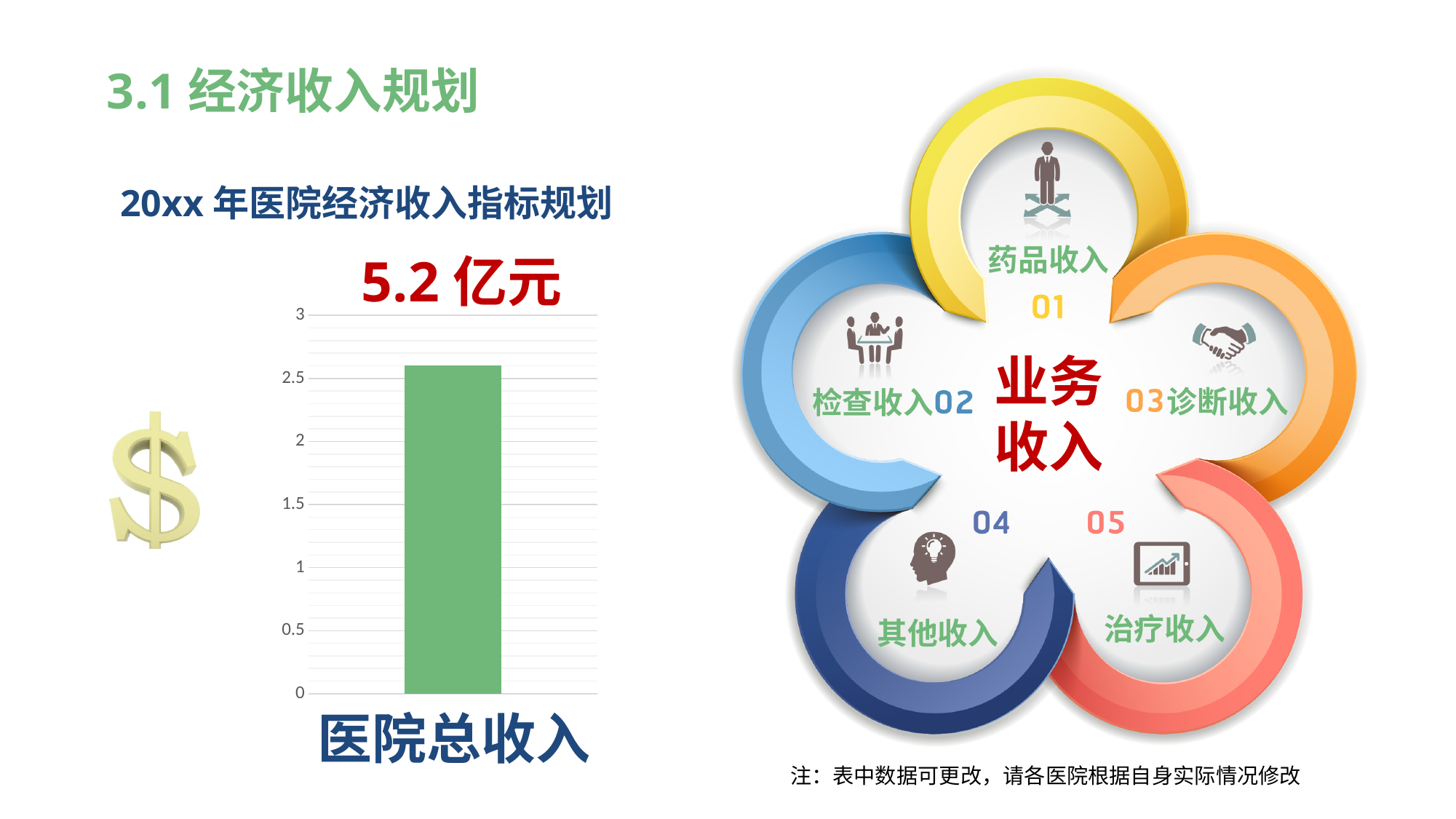
Is the value of the 医院总收入 bar greater or less than 2? greater What is the category label under the bar in the chart? 医院总收入 What kind of chart is shown on the slide? bar chart Is the value of the 医院总收入 bar greater or less than 3? less How many bars does the chart contain? 1 Is the value of the 医院总收入 bar greater or less than 1? greater What is the title shown above the bar chart? 20xx 年医院经济收入指标规划 What figure in red is displayed above the bar in the chart? 5.2 亿元